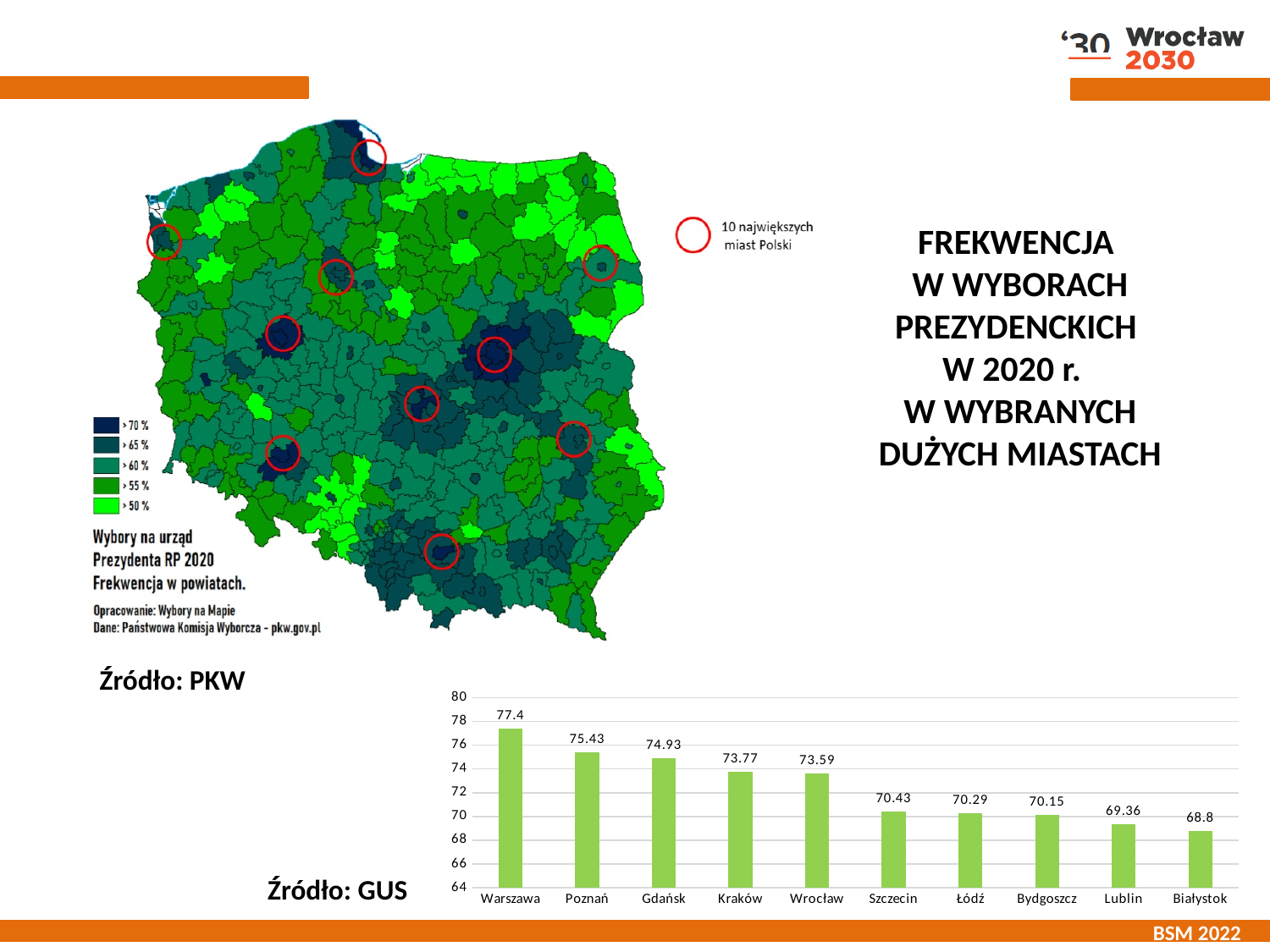
In the bar chart, do the values rise or fall from left to right? fall In the bar chart, which city has the lowest value? Białystok What kind of chart is shown at the bottom of the slide? bar chart In the bar chart, what is the difference between the values for Warszawa and Białystok? 8.6 In the bar chart, which city has the highest value? Warszawa In the bar chart, what is the value for Wrocław? 73.59 In the bar chart, what is the difference between the values for Poznań and Gdańsk? 0.5 In the bar chart, is the value for Lublin greater or less than 70? less How many cities are shown in the bar chart? 10 In the bar chart, what is the value for Białystok? 68.8 In the bar chart, what is the value for Warszawa? 77.4 In the bar chart, which is larger, the value for Kraków or the value for Szczecin? Kraków